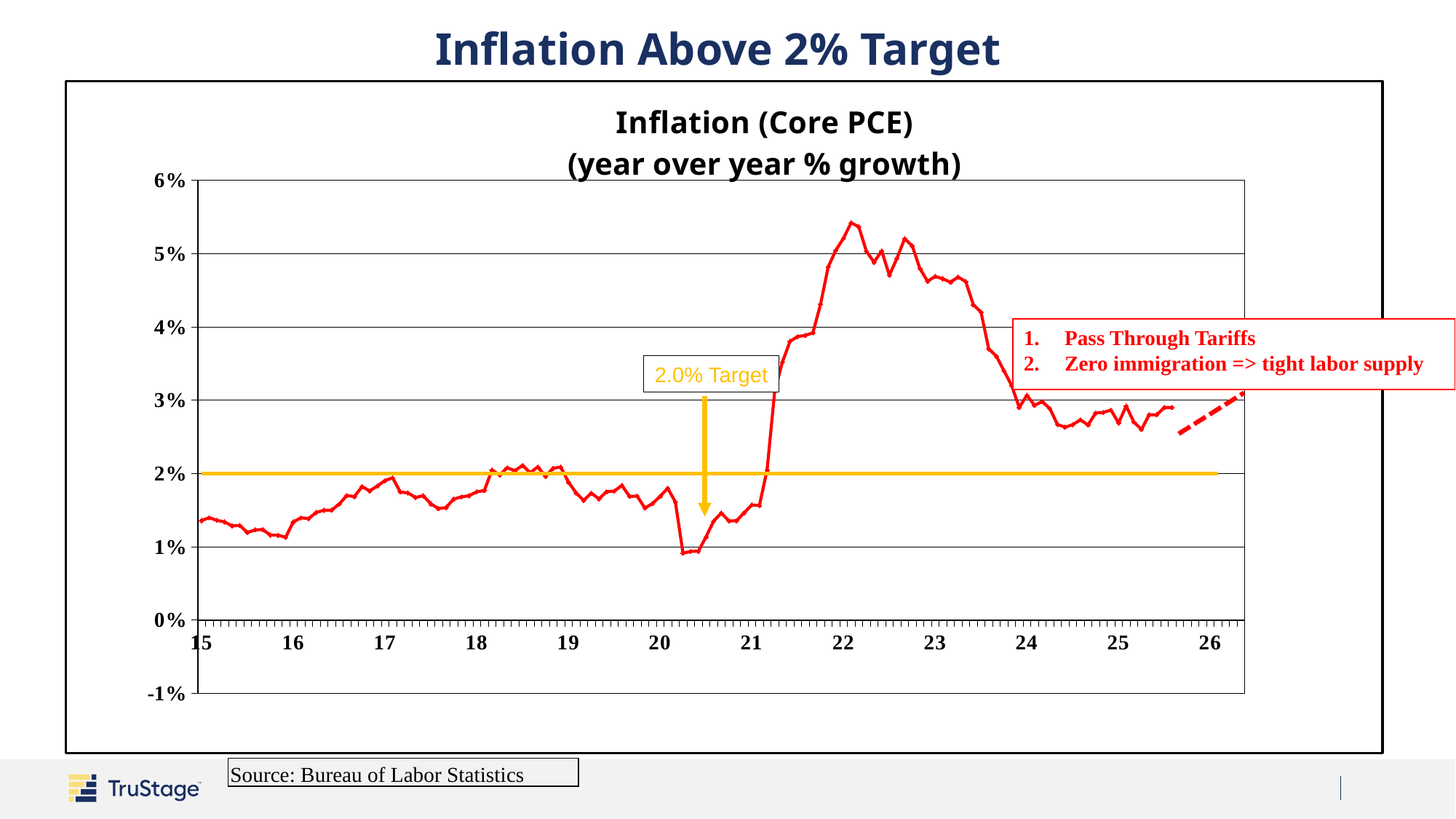
Around which year does the inflation line reach its lowest point? 2020 What kind of chart is shown on the slide? Line chart Is the inflation value at the start of 2024 greater or less than 2%? greater What value does the horizontal yellow target line mark? 2.0% Is the inflation value at the start of 2016 greater or less than 2%? less Is the peak value of the inflation line, reached around 2022, greater or less than 5%? greater Does the inflation line rise or fall between 2021 and 2022? Rise Around which year does the inflation line reach its highest point? 2022 What is the title of the chart? Inflation (Core PCE) (year over year % growth) Does the inflation line rise or fall between 2023 and 2024? Fall